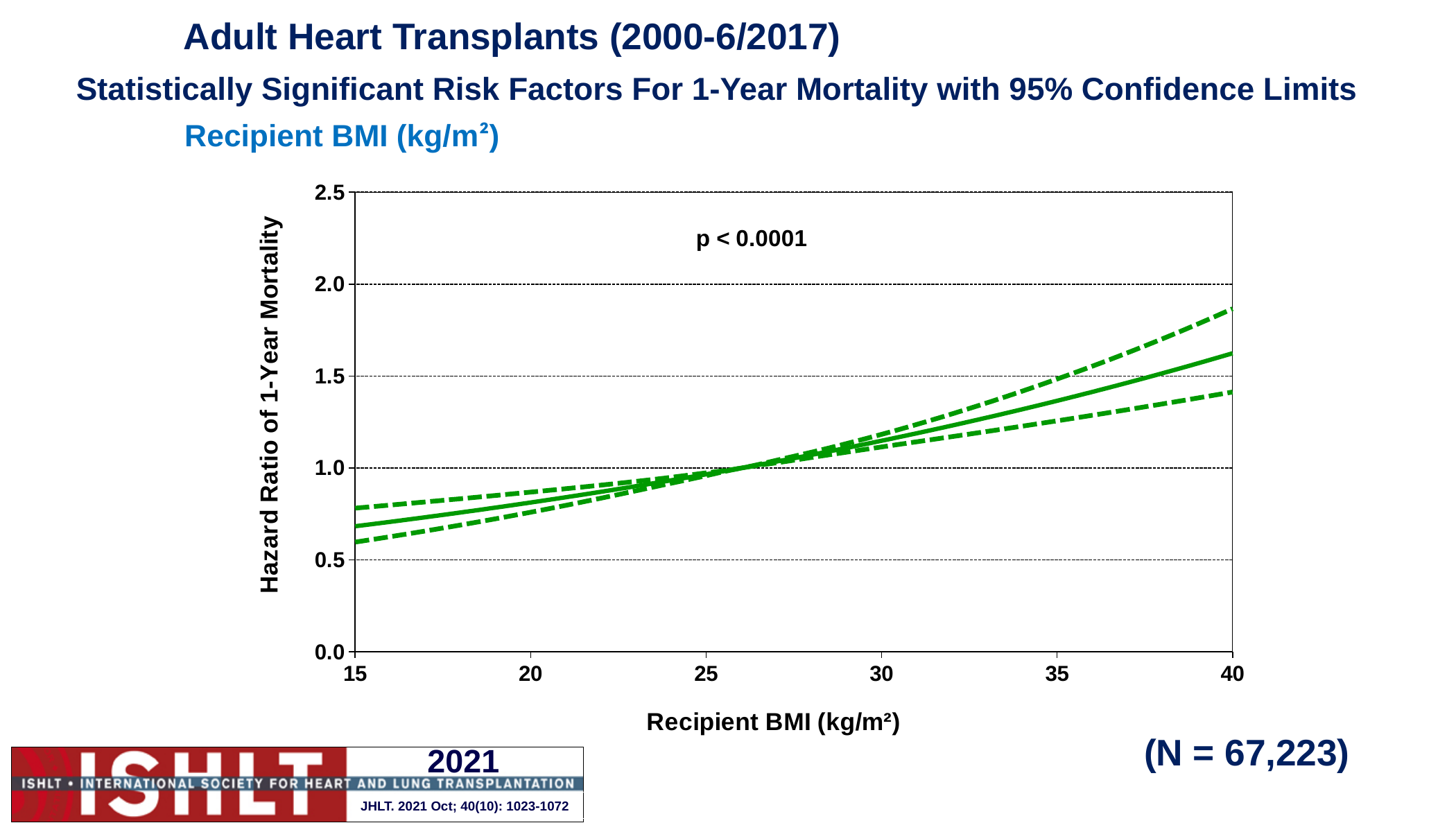
What kind of chart is shown on the slide? Line chart How many lines are plotted on the chart? 3 Is the hazard ratio (solid line) at a recipient BMI of 40 greater or less than 1.5? greater Is the hazard ratio (solid line) at a recipient BMI of 20 greater or less than 1.0? less Does the hazard ratio of 1-year mortality rise or fall as recipient BMI increases from 15 to 40? Rises What p-value is printed on the chart? p < 0.0001 Is the upper 95% confidence limit (upper dashed line) at a recipient BMI of 40 greater or less than 2.0? less What is the sample size (N) shown on the slide? N = 67,223